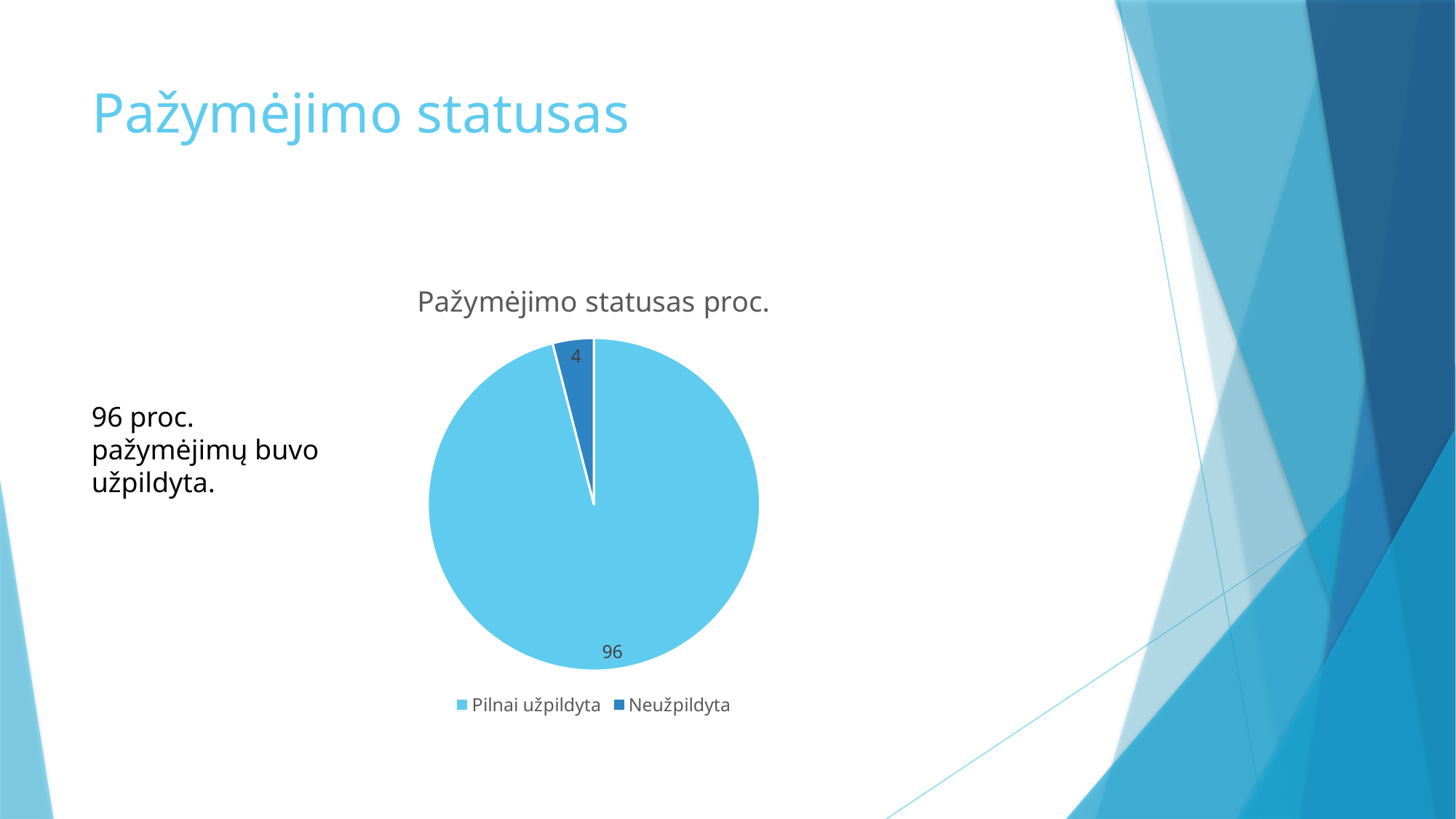
What is the difference between the values for Pilnai užpildyta and Neužpildyta? 92 What share of the pie does Neužpildyta represent? 4% What is the total of the two slice values? 100 Which category has the largest slice? Pilnai užpildyta What is the value for Pilnai užpildyta? 96 Which category has the smallest slice? Neužpildyta How many slices does the pie chart have? 2 What is the value for Neužpildyta? 4 Which is larger, Pilnai užpildyta or Neužpildyta? Pilnai užpildyta What is the title of the chart? Pažymėjimo statusas proc. What kind of chart is shown on the slide? pie chart How many entries does the legend list? 2